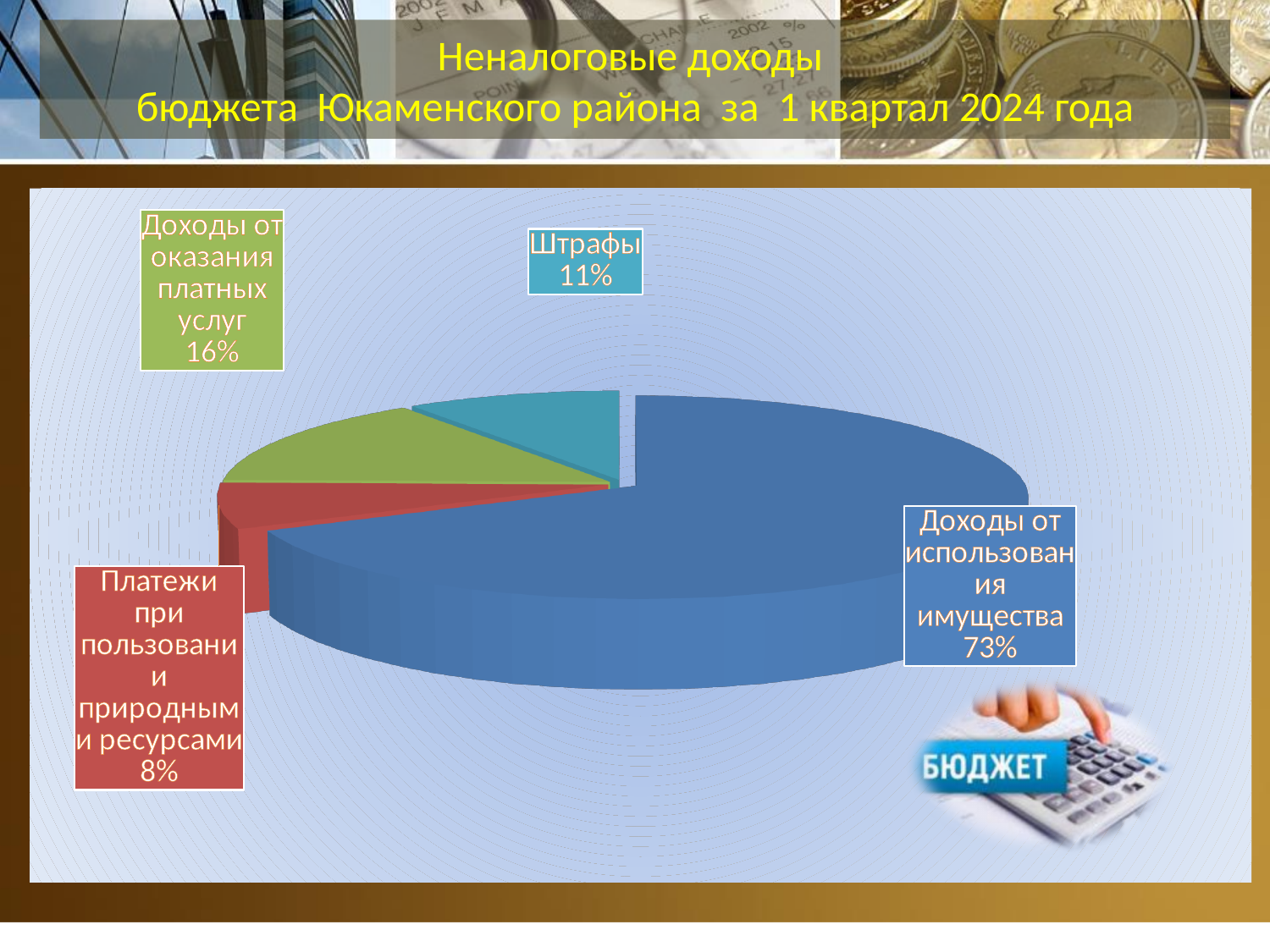
What type of chart is shown on the slide? Pie chart What share of the pie does "Штрафы" have? 11% What is the difference in percentage points between "Доходы от использования имущества" and "Штрафы"? 62 What is the title of the slide containing the chart? Неналоговые доходы бюджета Юкаменского района за 1 квартал 2024 года What share of the pie does "Доходы от оказания платных услуг" have? 16% What share of the pie does "Платежи при пользовании природными ресурсами" have? 8% What is the difference in percentage points between "Доходы от оказания платных услуг" and "Платежи при пользовании природными ресурсами"? 8 Which category has the smallest slice of the pie? Платежи при пользовании природными ресурсами Which category has the largest slice of the pie? Доходы от использования имущества What share of the pie does "Доходы от использования имущества" have? 73% Which is larger: the share for "Штрафы" or the share for "Доходы от оказания платных услуг"? Доходы от оказания платных услуг How many slices does the pie chart have? 4